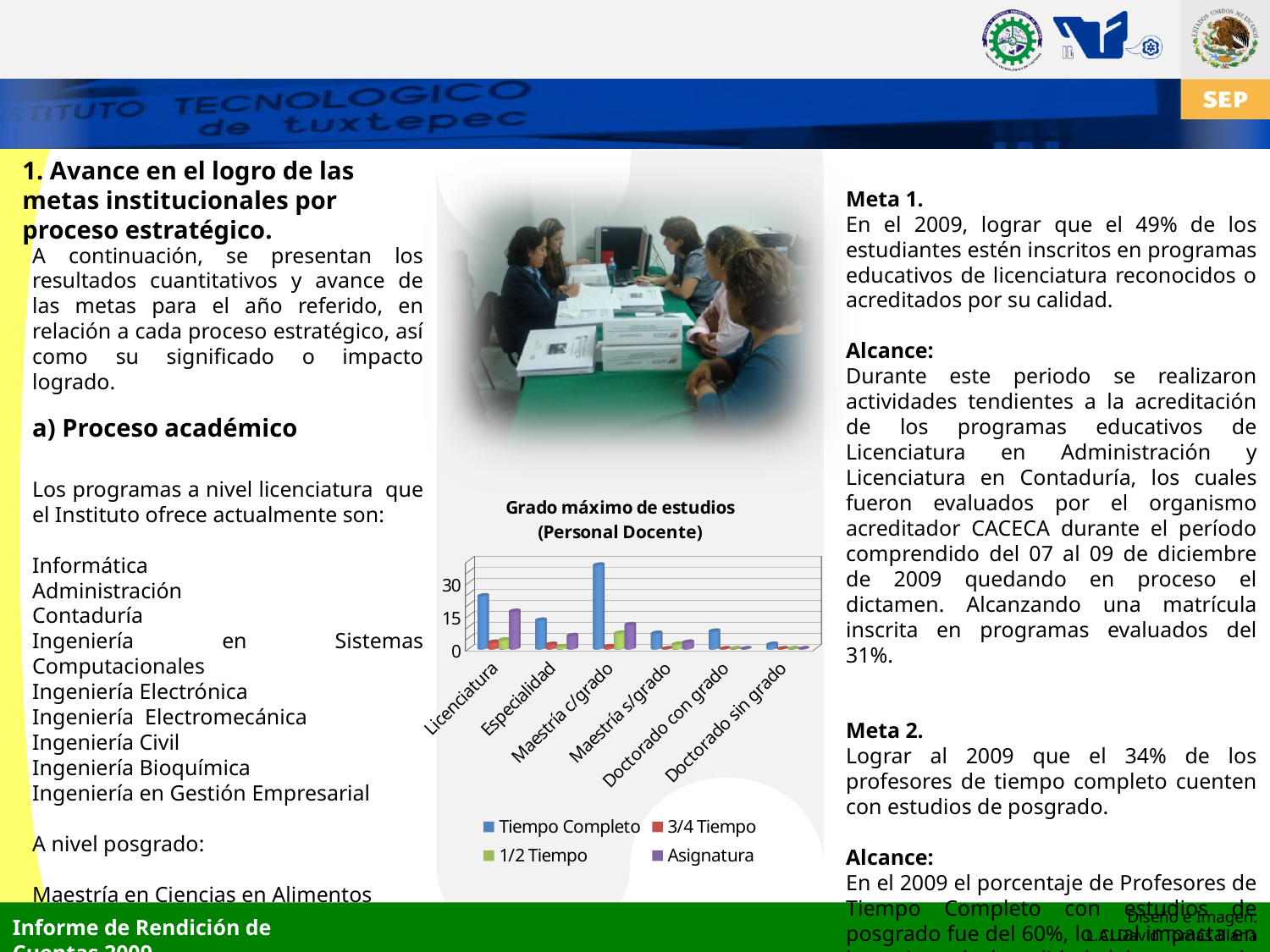
In the "Grado máximo de estudios" chart, is the Tiempo Completo value for Maestría c/grado greater or less than 30? greater Which series in the "Grado máximo de estudios" chart is shown in purple? Asignatura In the "Grado máximo de estudios" chart, is the Tiempo Completo value for Licenciatura greater or less than 15? greater In the "Grado máximo de estudios" chart, for Licenciatura, which series is larger: Asignatura or 3/4 Tiempo? Asignatura In the "Grado máximo de estudios" chart, which category has the highest value for Tiempo Completo? Maestría c/grado What is the title of the chart on the slide? Grado máximo de estudios (Personal Docente) How many series does the legend of the "Grado máximo de estudios" chart list? 4 How many categories are shown on the x axis of the "Grado máximo de estudios" chart? 6 In the "Grado máximo de estudios" chart, is the Tiempo Completo value for Doctorado sin grado greater or less than 15? less In the "Grado máximo de estudios" chart, which is larger for Tiempo Completo: Licenciatura or Especialidad? Licenciatura What kind of chart is shown under the title "Grado máximo de estudios (Personal Docente)"? bar chart